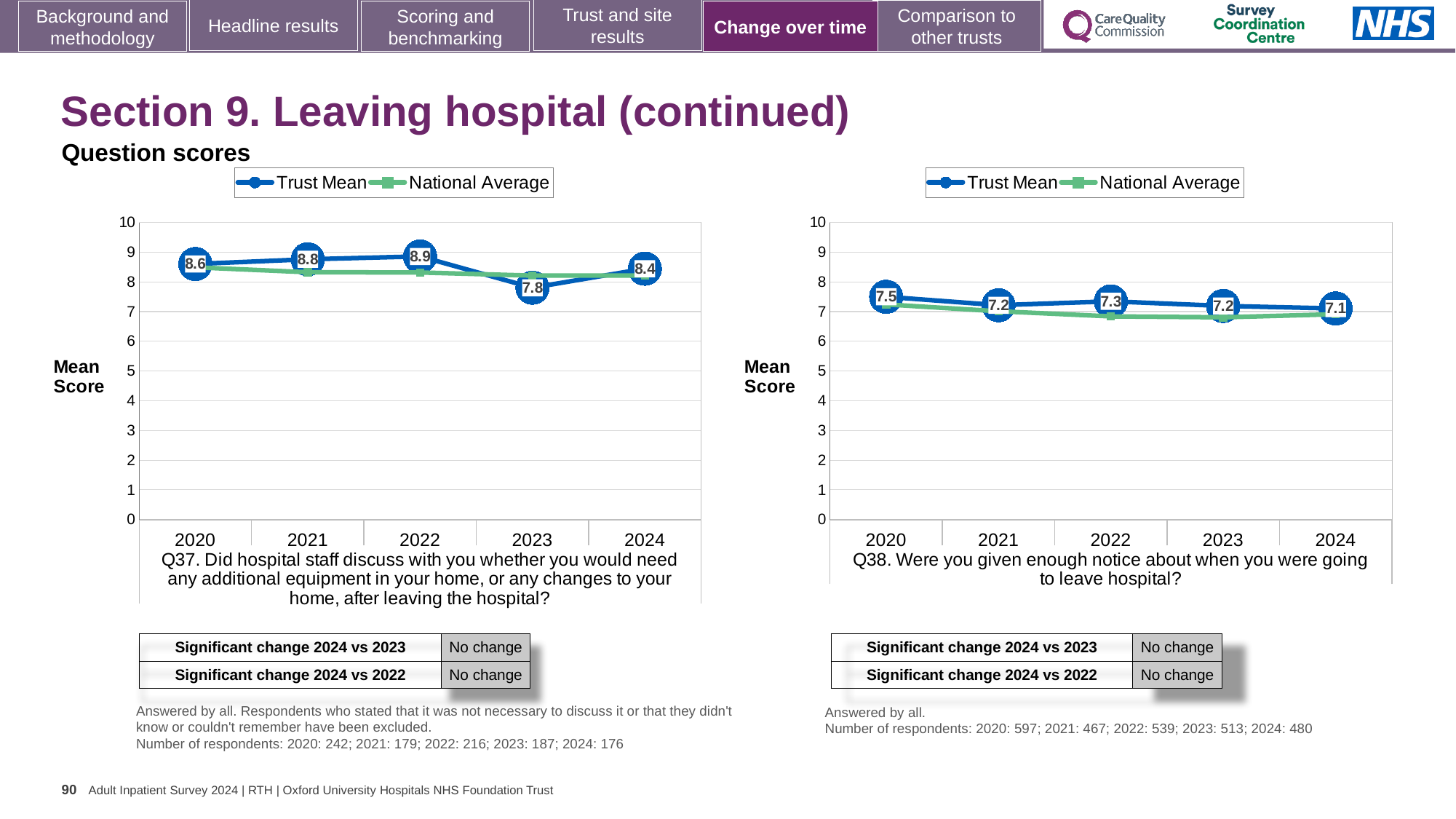
In the Q37 chart, which year has the lowest Trust Mean score? 2023 In the Q38 chart, which year has the highest Trust Mean score? 2020 In the Q37 chart, which year has the highest Trust Mean score? 2022 In the Q37 chart, what is the Trust Mean score for 2022? 8.9 In the Q37 chart, what is the difference between the Trust Mean scores for 2022 and 2023? 1.1 How many series does the legend of the Q38 chart list? 2 In the Q38 chart, what is the Trust Mean score for 2020? 7.5 In the Q38 chart, is the National Average for 2023 greater or less than 8? less In the Q38 chart, what is the Trust Mean score for 2024? 7.1 In the Q37 chart, what is the Trust Mean score for 2023? 7.8 In the Q37 chart, is the Trust Mean score for 2021 greater or less than the Trust Mean score for 2024? greater In the Q38 chart, what is the difference between the Trust Mean scores for 2020 and 2024? 0.4